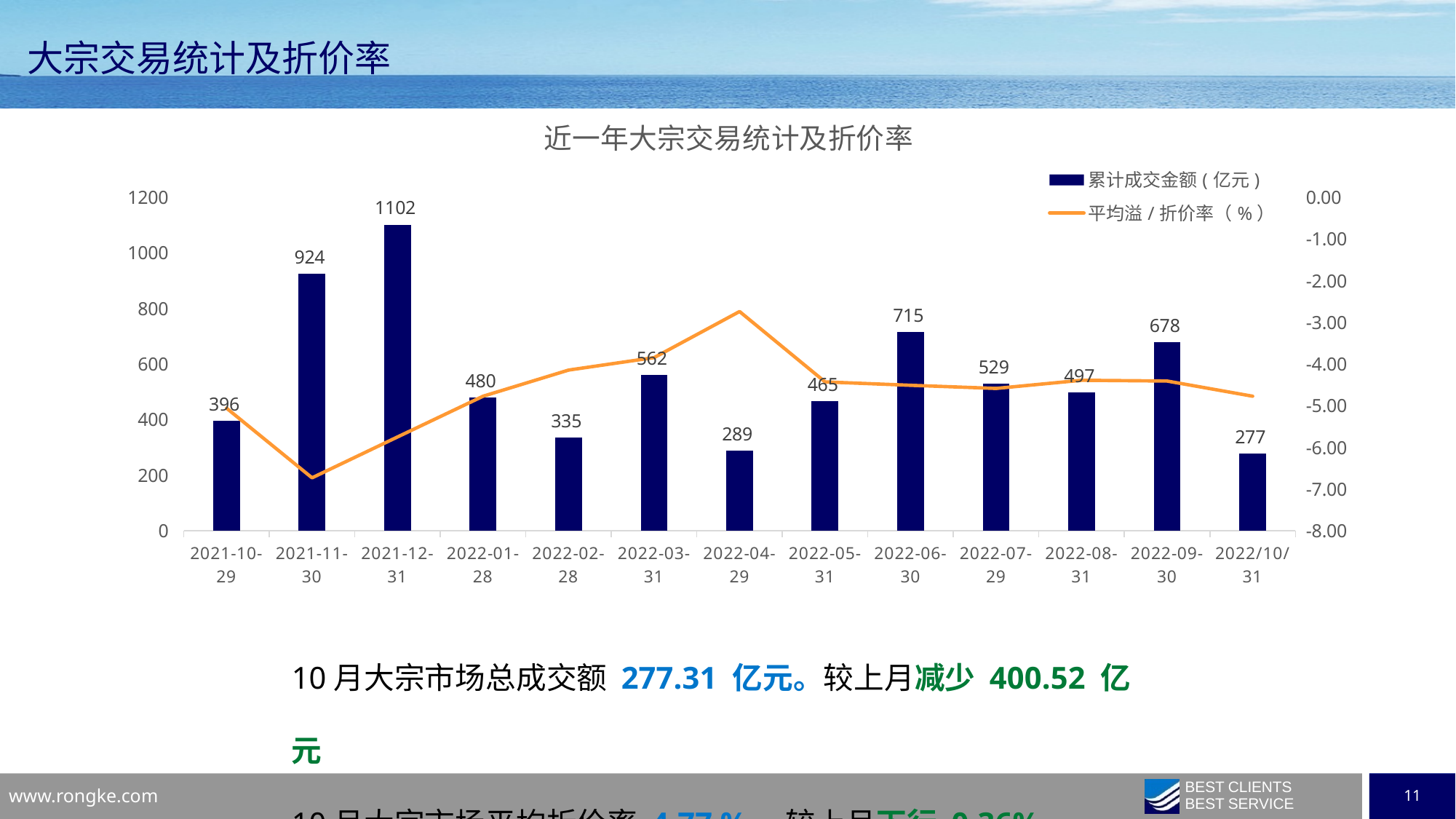
What is the difference in 累计成交金额 (亿元) between 2022-09-30 and 2022/10/31? 401 How many months are shown on the x axis? 13 What is the 累计成交金额 (亿元) value for 2022/10/31? 277 Which month has the highest 累计成交金额 (亿元)? 2021-12-31 Is the 平均溢/折价率 (%) value for 2022-04-29 greater or less than -3.00? greater How many series does the legend list? 2 What type of chart is shown on the slide? Combined bar and line chart What is the title of the chart? 近一年大宗交易统计及折价率 What is the 累计成交金额 (亿元) value for 2021-12-31? 1102 Which has a larger 累计成交金额 (亿元): 2022-03-31 or 2022-07-29? 2022-03-31 Which month has the lowest 累计成交金额 (亿元)? 2022/10/31 What is the 累计成交金额 (亿元) value for 2022-06-30? 715